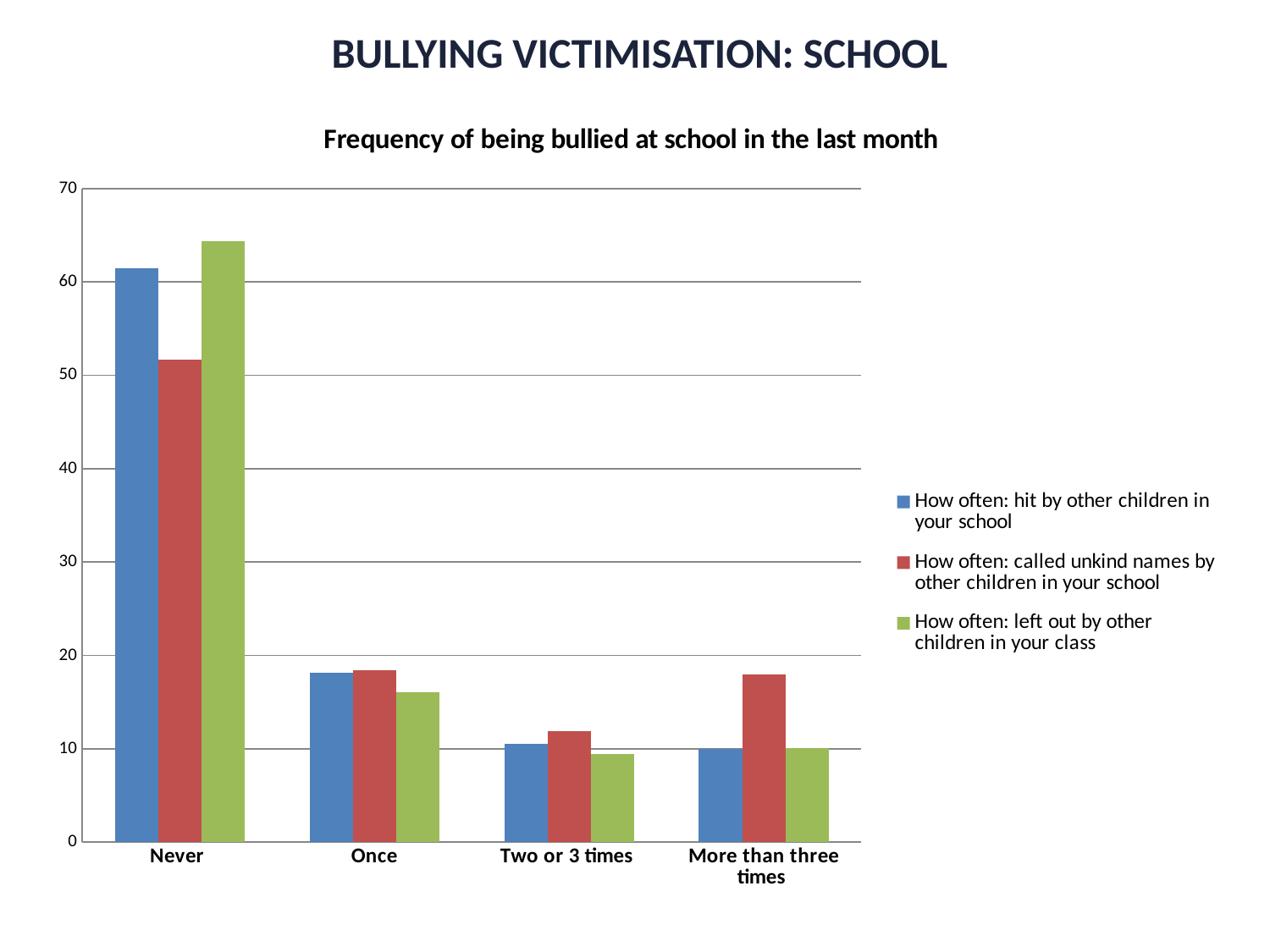
In the 'More than three times' category, which series has the tallest bar? How often: called unkind names by other children in your school What is the title of the chart? Frequency of being bullied at school in the last month Is the value for 'How often: called unkind names by other children in your school' in the 'More than three times' category greater or less than 10? greater In the 'Never' category, which is larger: the value for 'hit by other children in your school' or the value for 'called unkind names by other children in your school'? How often: hit by other children in your school What kind of chart is shown on the slide? bar chart In the 'Never' category, which series has the tallest bar? How often: left out by other children in your class Is the value for 'How often: left out by other children in your class' in the 'Once' category greater or less than 20? less Is the value for 'How often: left out by other children in your class' in the 'Never' category greater or less than 60? greater Which category has the highest values for all three series? Never How many series does the legend list? 3 How many categories are shown on the x axis? 4